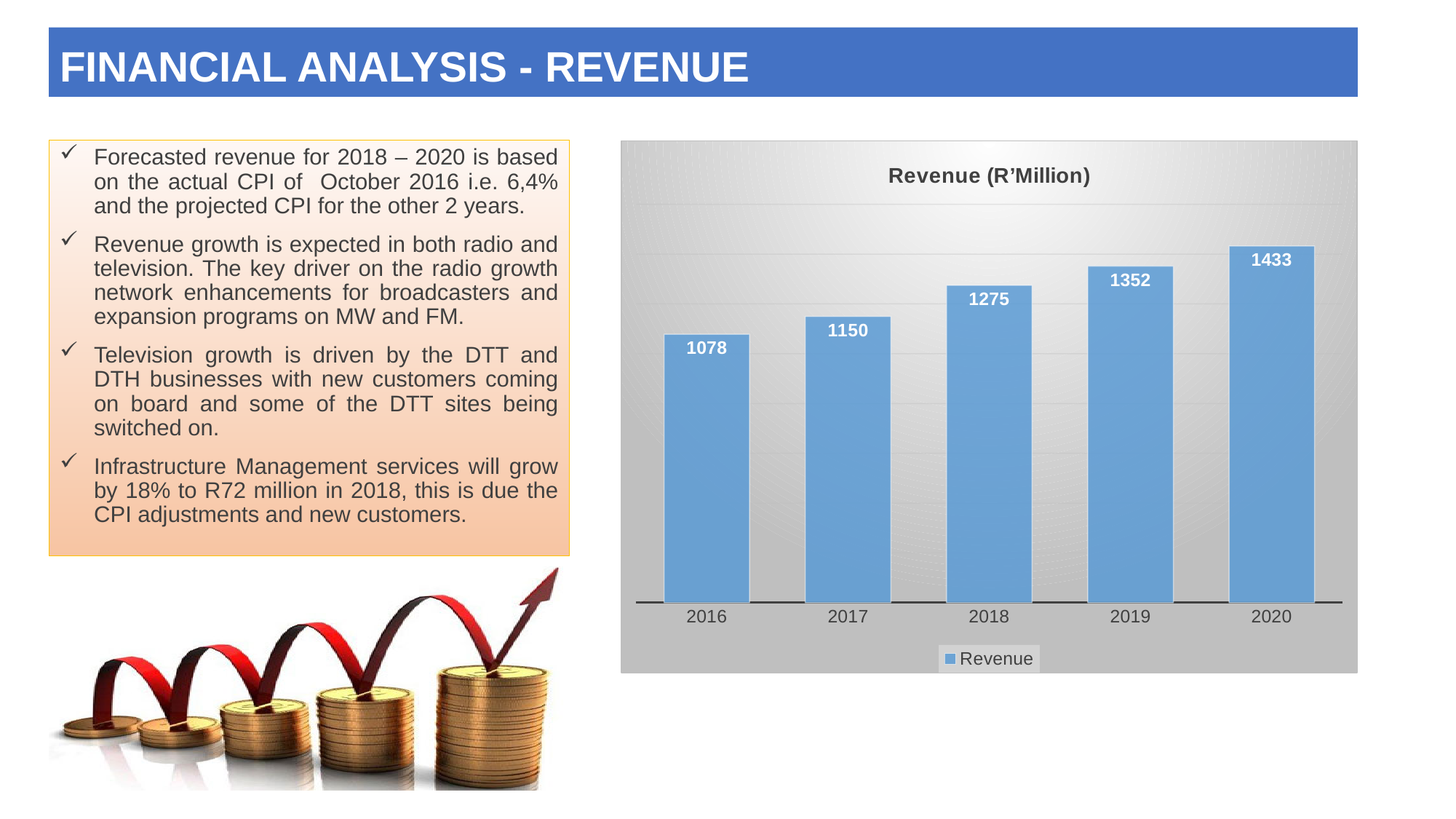
What is the revenue value for 2016? 1078 Do the revenue values rise or fall from 2016 to 2020? rise Which year has the lowest revenue? 2016 What is the difference between the revenue for 2020 and the revenue for 2016? 355 Which year has the highest revenue? 2020 How many years are shown on the x axis of the chart? 5 What is the difference between the revenue for 2019 and the revenue for 2018? 77 What is the revenue value for 2018? 1275 What kind of chart is shown on the slide? bar chart What is the revenue value for 2020? 1433 Which is larger, the revenue for 2017 or the revenue for 2019? 2019 How many series does the legend list? 1